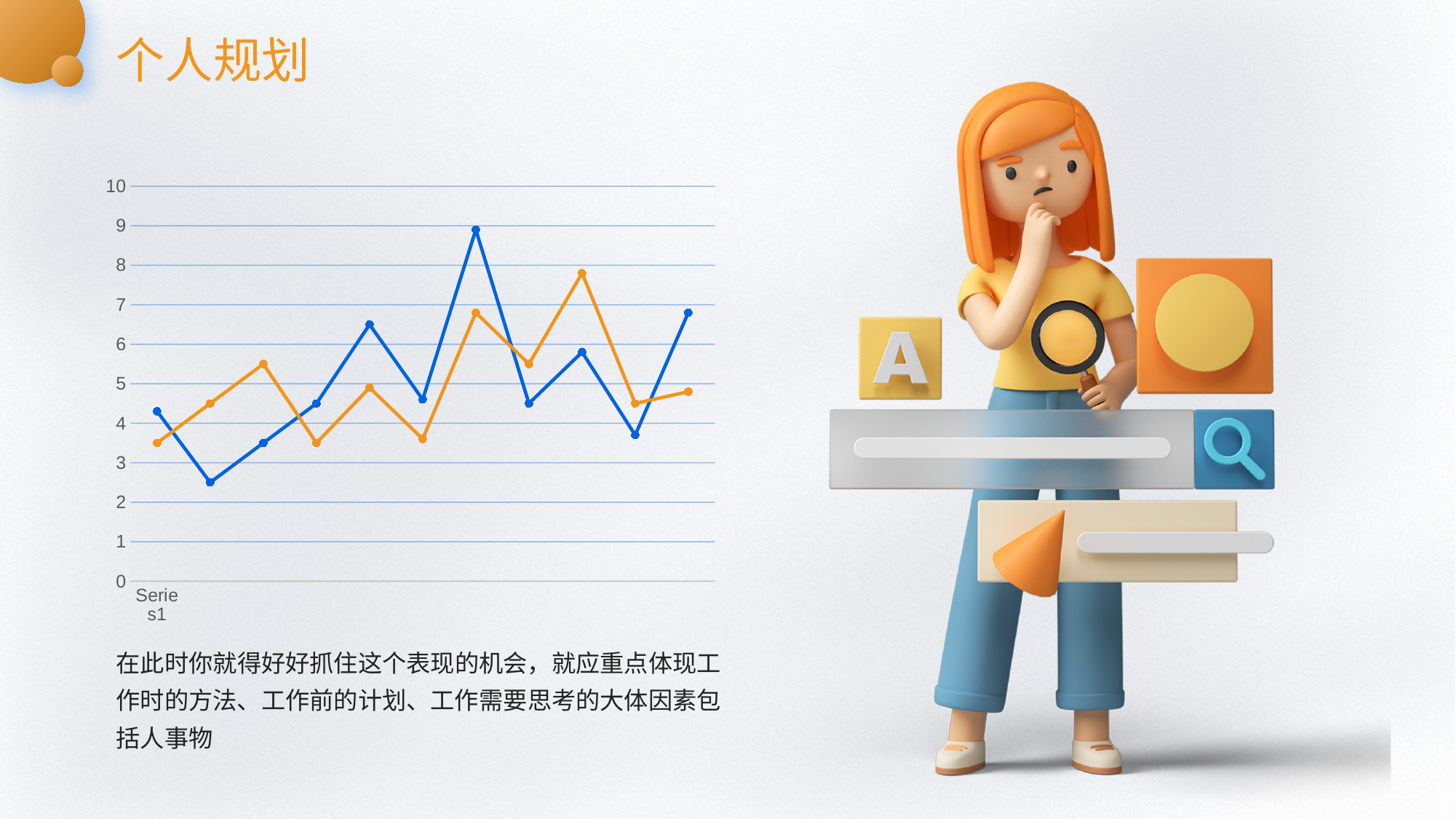
Is the lowest point of the orange line greater or less than 4? less Which line reaches the highest value on the chart, the blue line or the orange line? the blue line How many data points does the blue line have? 11 Is the lowest point of the blue line greater or less than 3? less How many lines are plotted on the chart? 2 Is the highest point of the blue line greater or less than 8? greater What kind of chart is shown on the slide? line chart Which line contains the lowest point on the chart, the blue line or the orange line? the blue line What is the maximum value shown on the vertical axis? 10 What label is shown on the horizontal axis of the chart? Series1 How many data points does the orange line have? 11